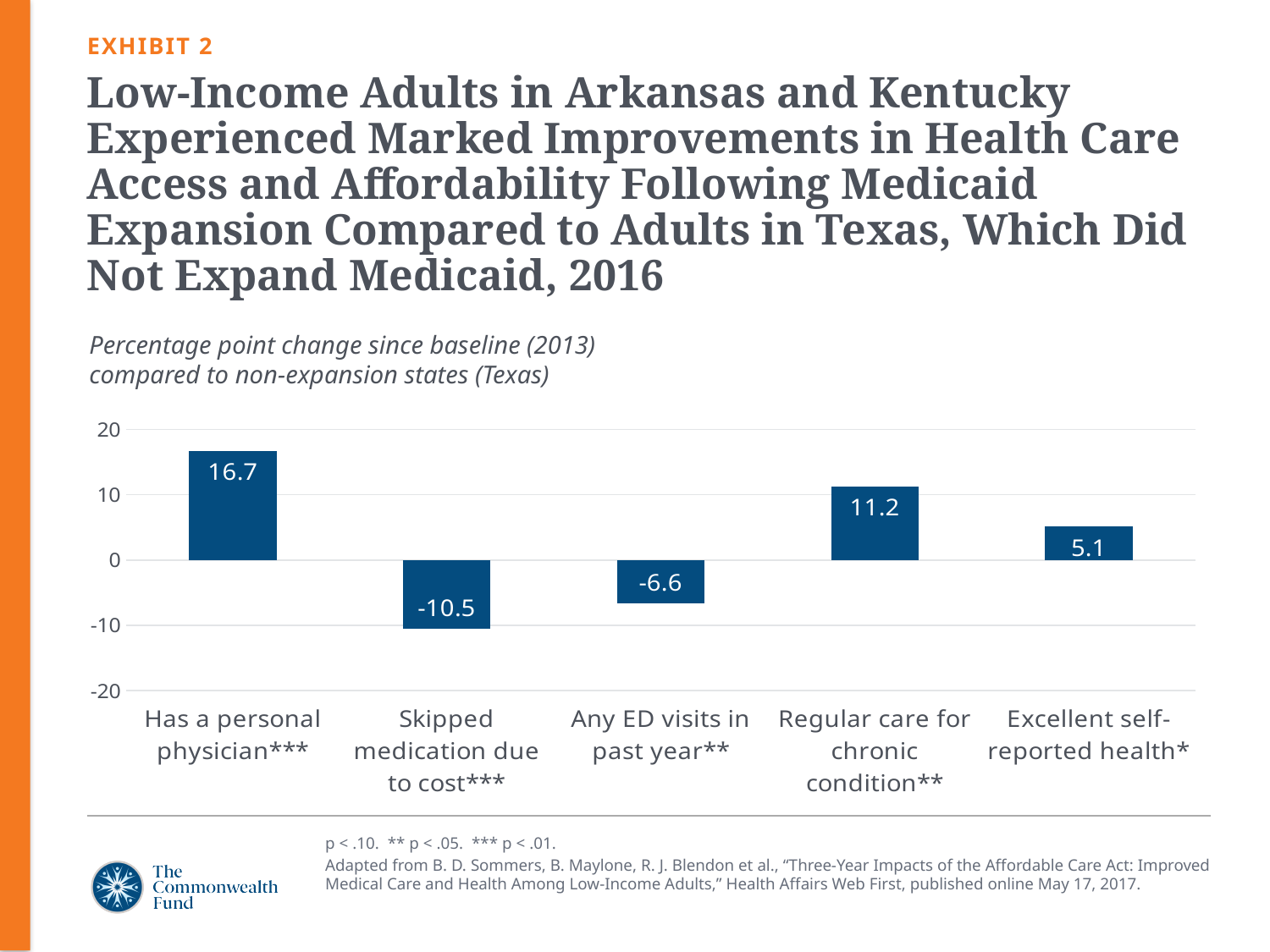
What is the difference between the values for "Has a personal physician" and "Regular care for chronic condition"? 5.5 What kind of chart is shown on the slide? Bar chart What is the value shown for "Excellent self-reported health"? 5.1 What is the percentage point change for "Has a personal physician"? 16.7 What is the value shown for "Any ED visits in past year"? -6.6 How many categories on the chart have negative values? 2 How many categories are shown on the chart? 5 Which category has the lowest value? Skipped medication due to cost What is the value shown for "Regular care for chronic condition"? 11.2 Which is larger, the value for "Regular care for chronic condition" or "Excellent self-reported health"? Regular care for chronic condition What is the value shown for "Skipped medication due to cost"? -10.5 Which category has the highest value? Has a personal physician